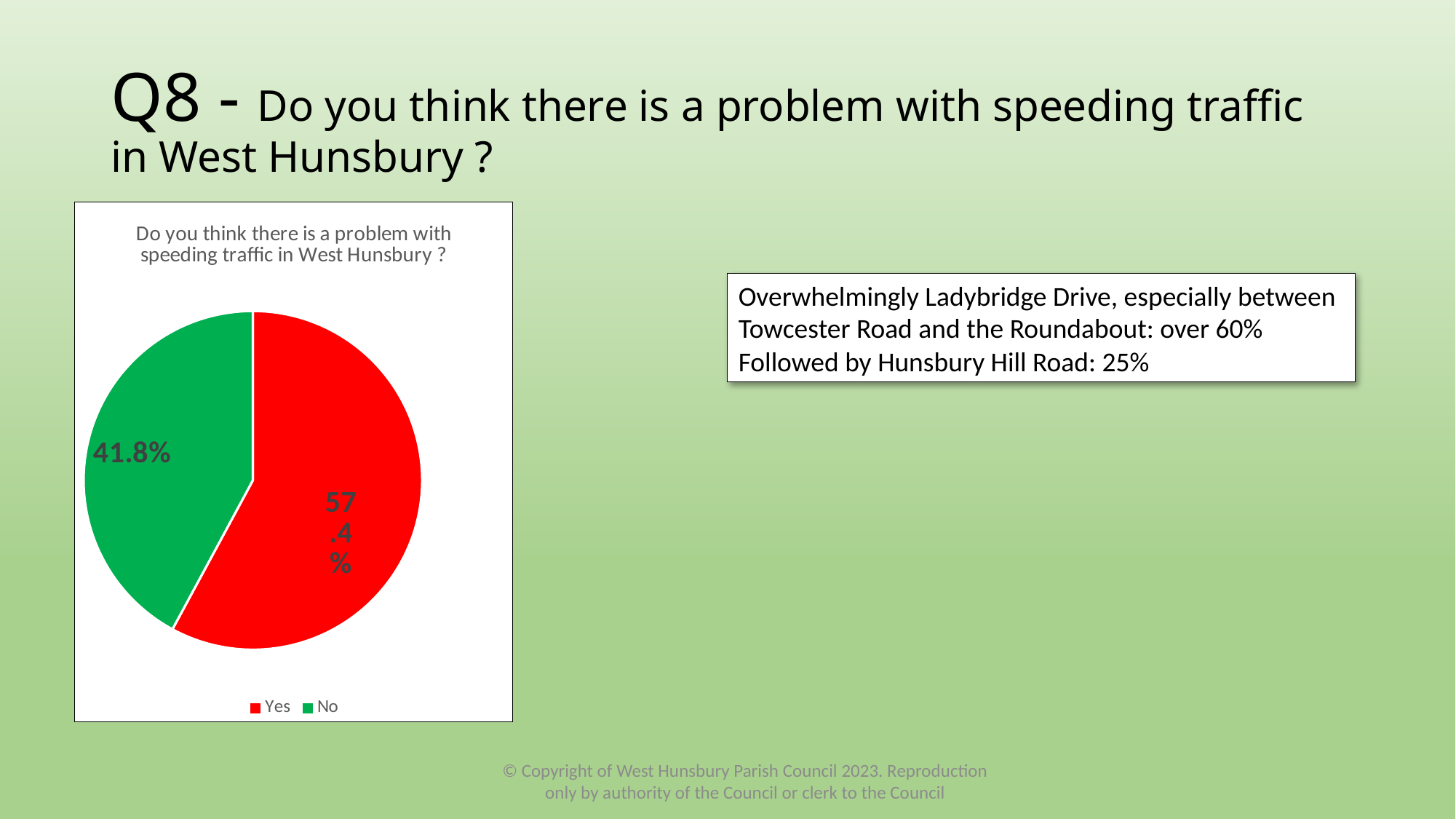
How many entries does the legend list? 2 What colour is the Yes slice? red Is the share for Yes larger or smaller than the share for No? larger What is the title of the chart? Do you think there is a problem with speeding traffic in West Hunsbury ? How many slices does the pie chart have? 2 What is the difference in percentage points between the Yes and No shares? 15.6 Which response has the smaller share of the pie? No What percentage of respondents answered No? 41.8% Which response has the larger share of the pie? Yes What percentage of respondents answered Yes? 57.4% What kind of chart is shown on the slide? pie chart